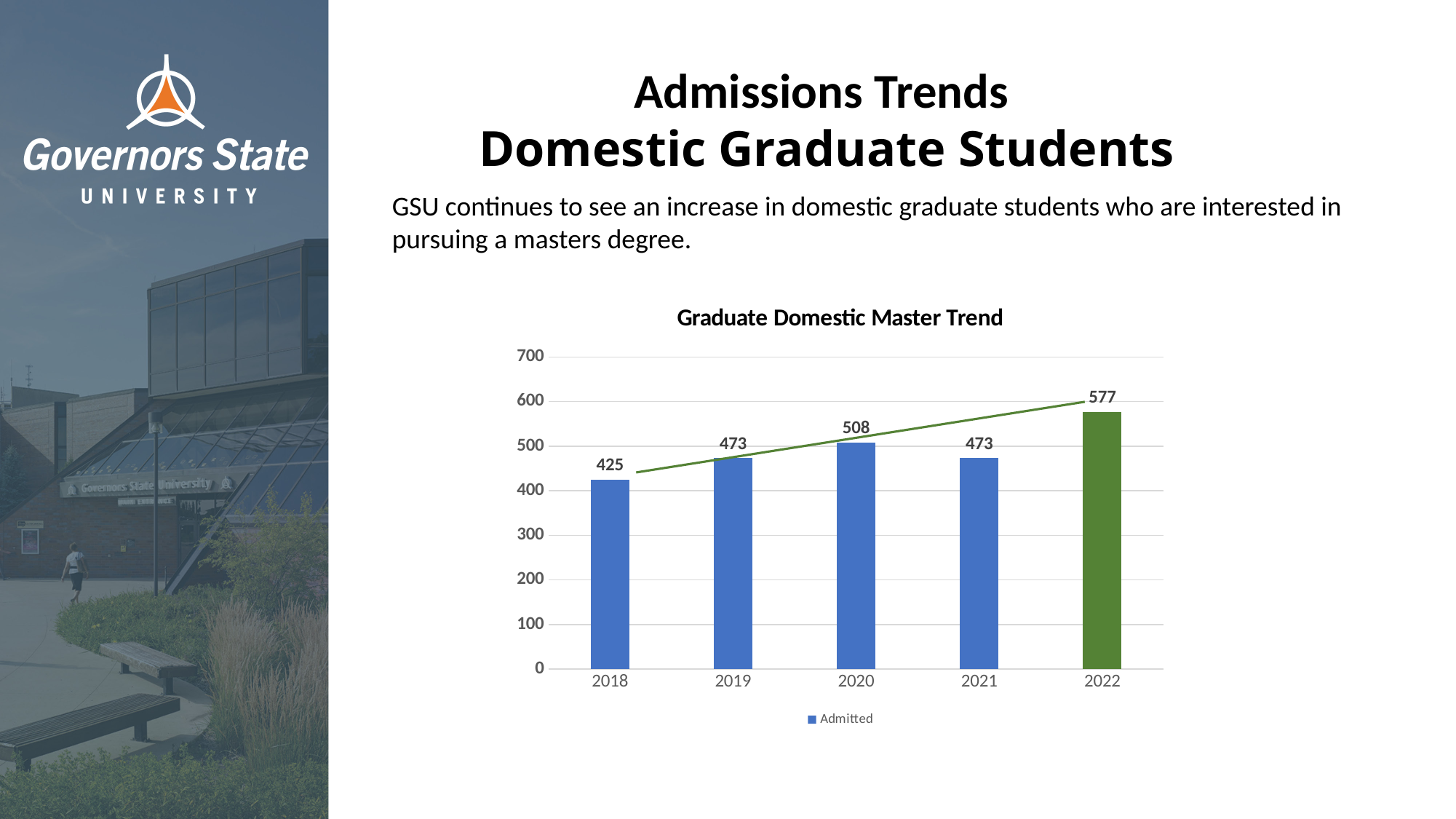
Is the value for 2022 in the Graduate Domestic Master Trend chart greater or less than 500? greater What is the difference between the 2020 and 2021 values in the Graduate Domestic Master Trend chart? 35 Which year has the lowest value in the Graduate Domestic Master Trend chart? 2018 What kind of chart is the Graduate Domestic Master Trend chart? bar chart What is the value for 2022 in the Graduate Domestic Master Trend chart? 577 What is the value for 2020 in the Graduate Domestic Master Trend chart? 508 Which is larger in the Graduate Domestic Master Trend chart, the value for 2020 or the value for 2021? 2020 What is the difference between the 2022 and 2018 values in the Graduate Domestic Master Trend chart? 152 Which year has the highest value in the Graduate Domestic Master Trend chart? 2022 What series name does the legend of the Graduate Domestic Master Trend chart show? Admitted How many years are shown on the x axis of the Graduate Domestic Master Trend chart? 5 What is the value for 2018 in the Graduate Domestic Master Trend chart? 425